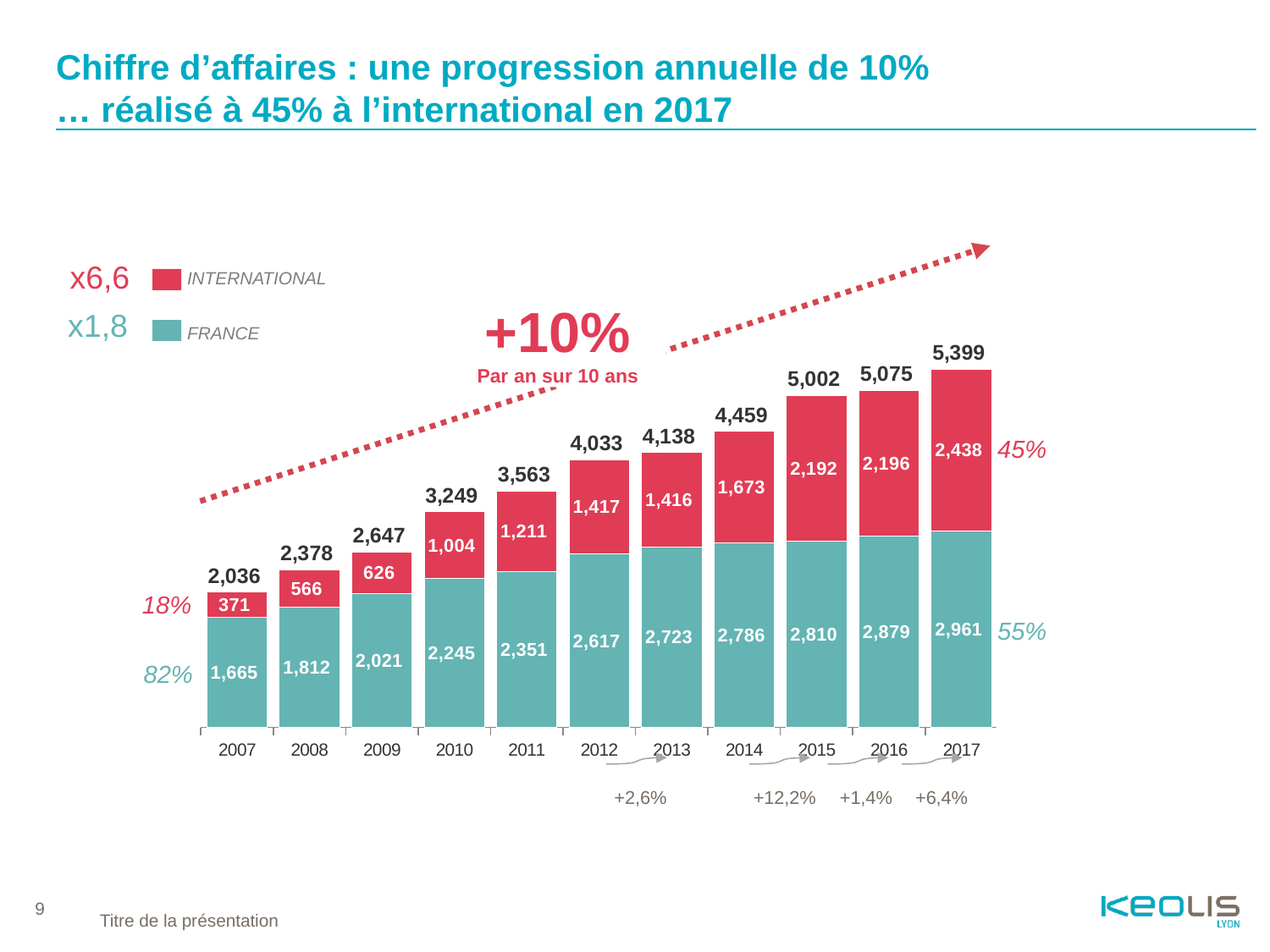
What is the difference between the total for 2017 and the total for 2007? 3,363 In 2015, which is larger: the FRANCE value or the INTERNATIONAL value? FRANCE Which year has the highest total bar? 2017 What is the FRANCE value for 2012? 2,617 Do the total values rise or fall from 2007 to 2017? Rise How many years are shown on the x axis? 11 What is the total labelled above the 2010 bar? 3,249 How many series does the legend list? 2 What is the difference between the FRANCE and INTERNATIONAL values in 2017? 523 What kind of chart is shown on the slide? Stacked bar chart Which year has the lowest total bar? 2007 What is the INTERNATIONAL value for 2015? 2,192